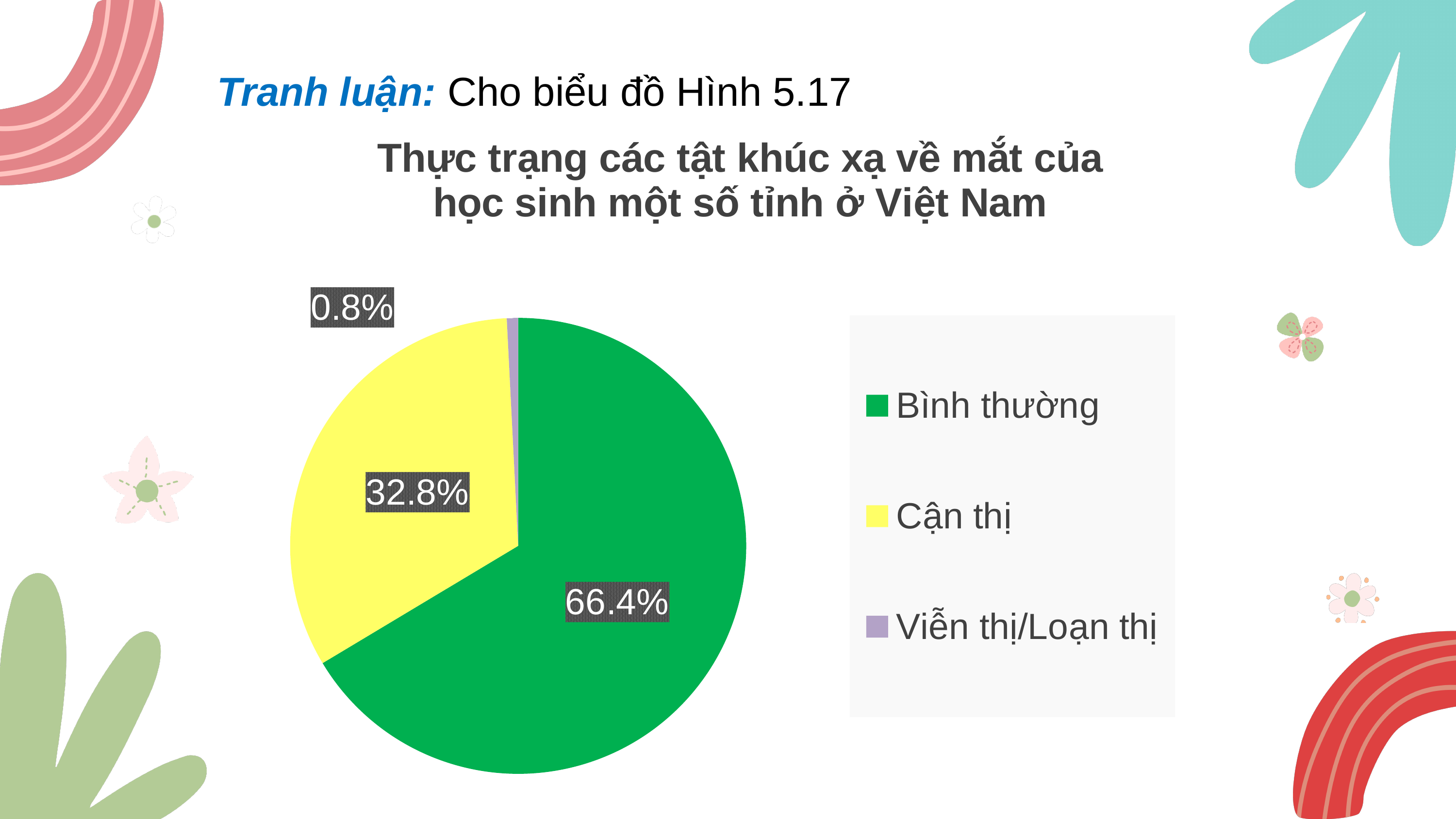
What is the value for Cận thị? 32.8% What is the difference between the values for Bình thường and Cận thị? 33.6% What is the value for Bình thường? 66.4% What type of chart is shown on the slide? pie chart Which is larger, the value for Cận thị or the value for Viễn thị/Loạn thị? Cận thị How many categories does the pie chart have? 3 Which category has the largest share of the pie? Bình thường What colour is the slice for Cận thị? yellow What is the value for Viễn thị/Loạn thị? 0.8% What is the title of the chart? Thực trạng các tật khúc xạ về mắt của học sinh một số tỉnh ở Việt Nam Which category has the smallest share of the pie? Viễn thị/Loạn thị What is the difference between the values for Cận thị and Viễn thị/Loạn thị? 32.0%